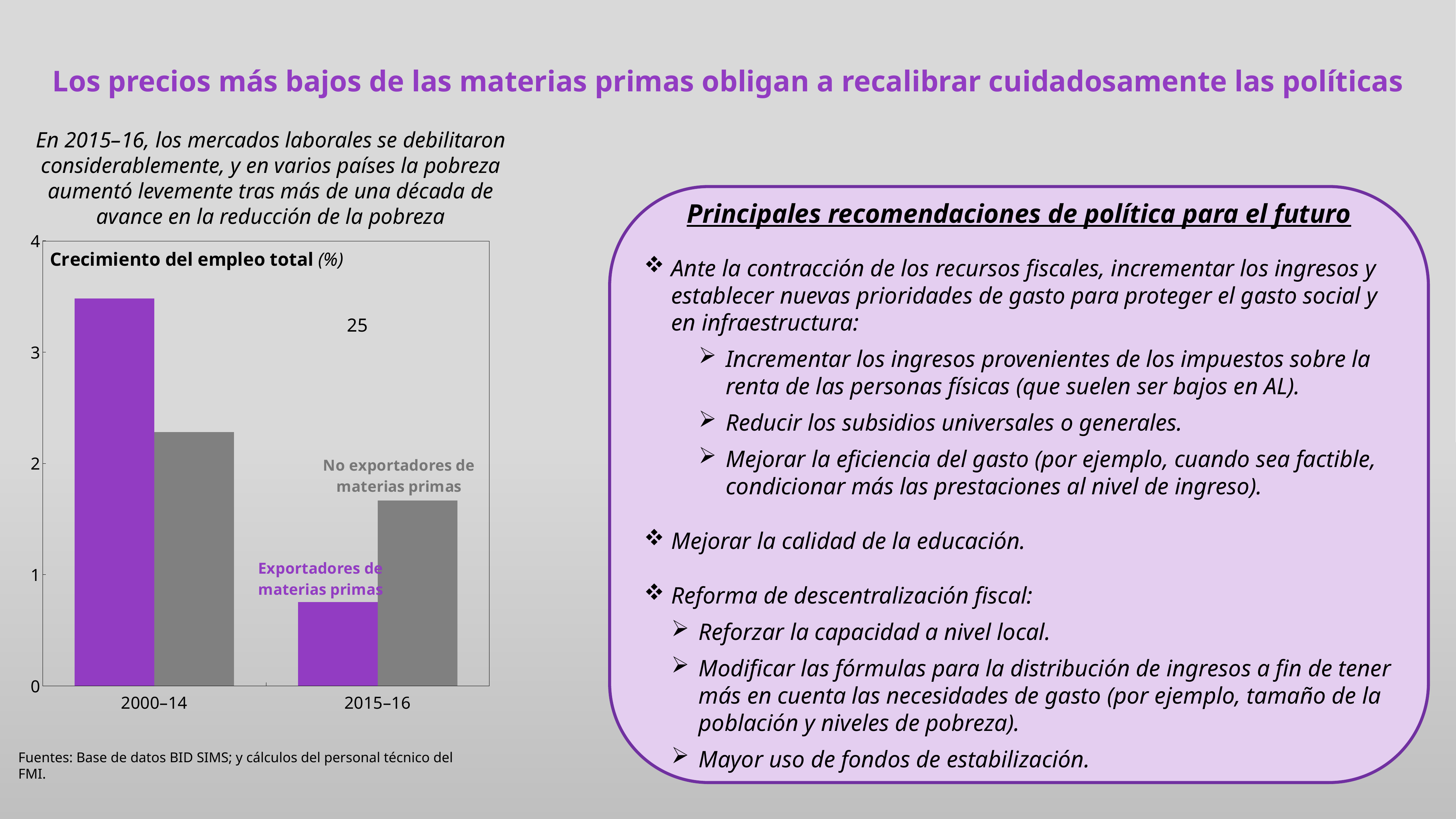
What kind of chart is shown on the slide? bar chart Which bar is the lowest in the chart? Exportadores de materias primas, 2015–16 In 2015–16, which group has higher employment growth: Exportadores de materias primas or No exportadores de materias primas? No exportadores de materias primas How many time periods are shown on the x axis of the chart? 2 Does employment growth for Exportadores de materias primas rise or fall from 2000–14 to 2015–16? fall Which bar is the highest in the chart? Exportadores de materias primas, 2000–14 What is the title of the chart? Crecimiento del empleo total (%) Is the value for Exportadores de materias primas in 2015–16 greater or less than 1? less In 2000–14, which group has higher employment growth: Exportadores de materias primas or No exportadores de materias primas? Exportadores de materias primas Which colour represents 'Exportadores de materias primas' in the chart? purple How many series does the chart show? 2 Is the value for Exportadores de materias primas in 2000–14 greater or less than 3? greater